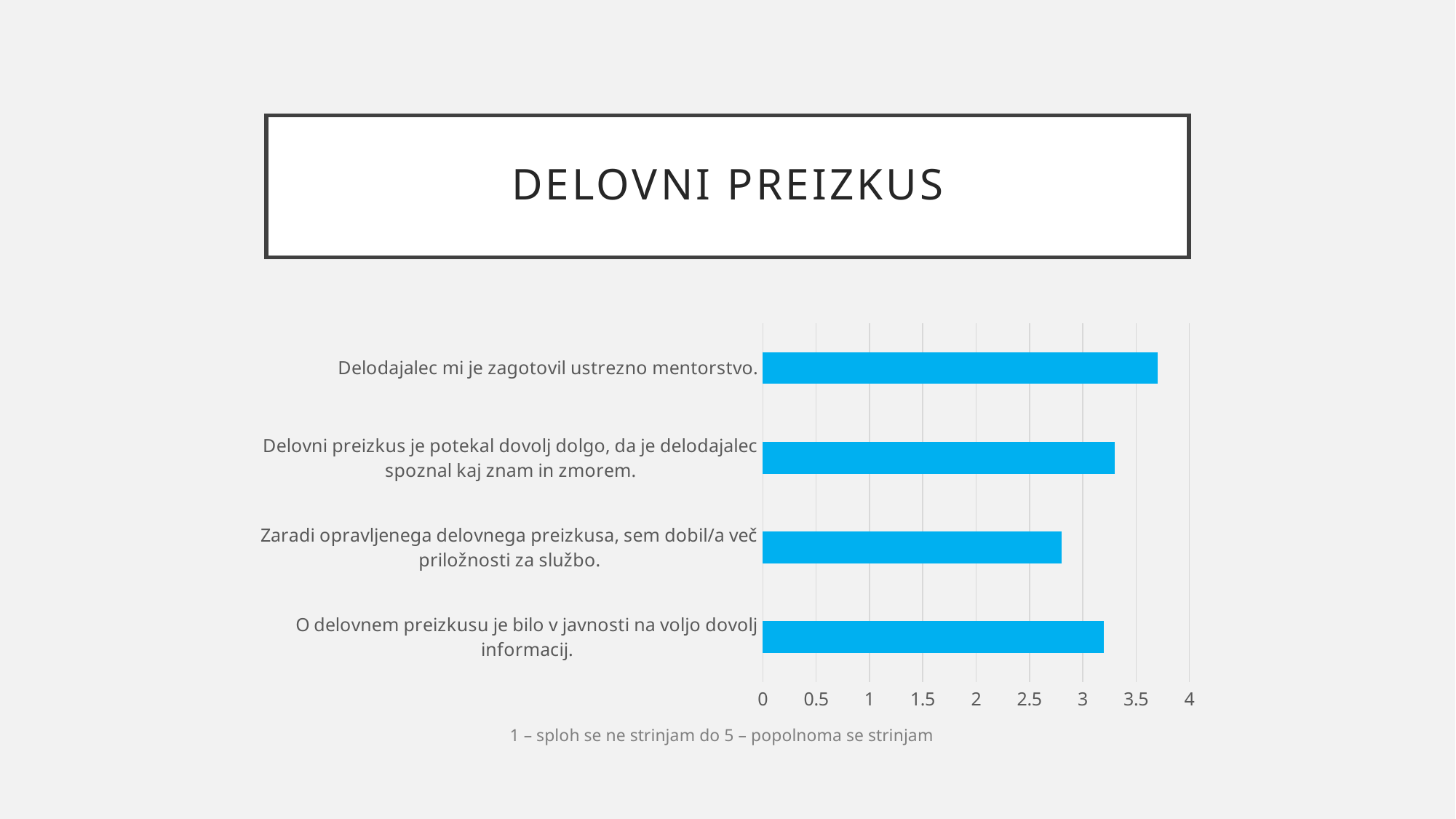
Which has a larger value: "Delodajalec mi je zagotovil ustrezno mentorstvo." or "O delovnem preizkusu je bilo v javnosti na voljo dovolj informacij."? Delodajalec mi je zagotovil ustrezno mentorstvo. Is the value for "Delovni preizkus je potekal dovolj dolgo, da je delodajalec spoznal kaj znam in zmorem." greater or less than 3? greater How many statements (categories) are plotted in the chart? 4 What is the maximum value shown on the horizontal axis of the chart? 4 What is the title shown above the chart on the slide? DELOVNI PREIZKUS Which statement has the highest value in the chart? Delodajalec mi je zagotovil ustrezno mentorstvo. Is the value for "Zaradi opravljenega delovnega preizkusa, sem dobil/a več priložnosti za službo." greater or less than 3? less Which statement has the lowest value in the chart? Zaradi opravljenega delovnega preizkusa, sem dobil/a več priložnosti za službo. Is the value for "O delovnem preizkusu je bilo v javnosti na voljo dovolj informacij." greater or less than 2.5? greater What kind of chart is shown on the slide? bar chart